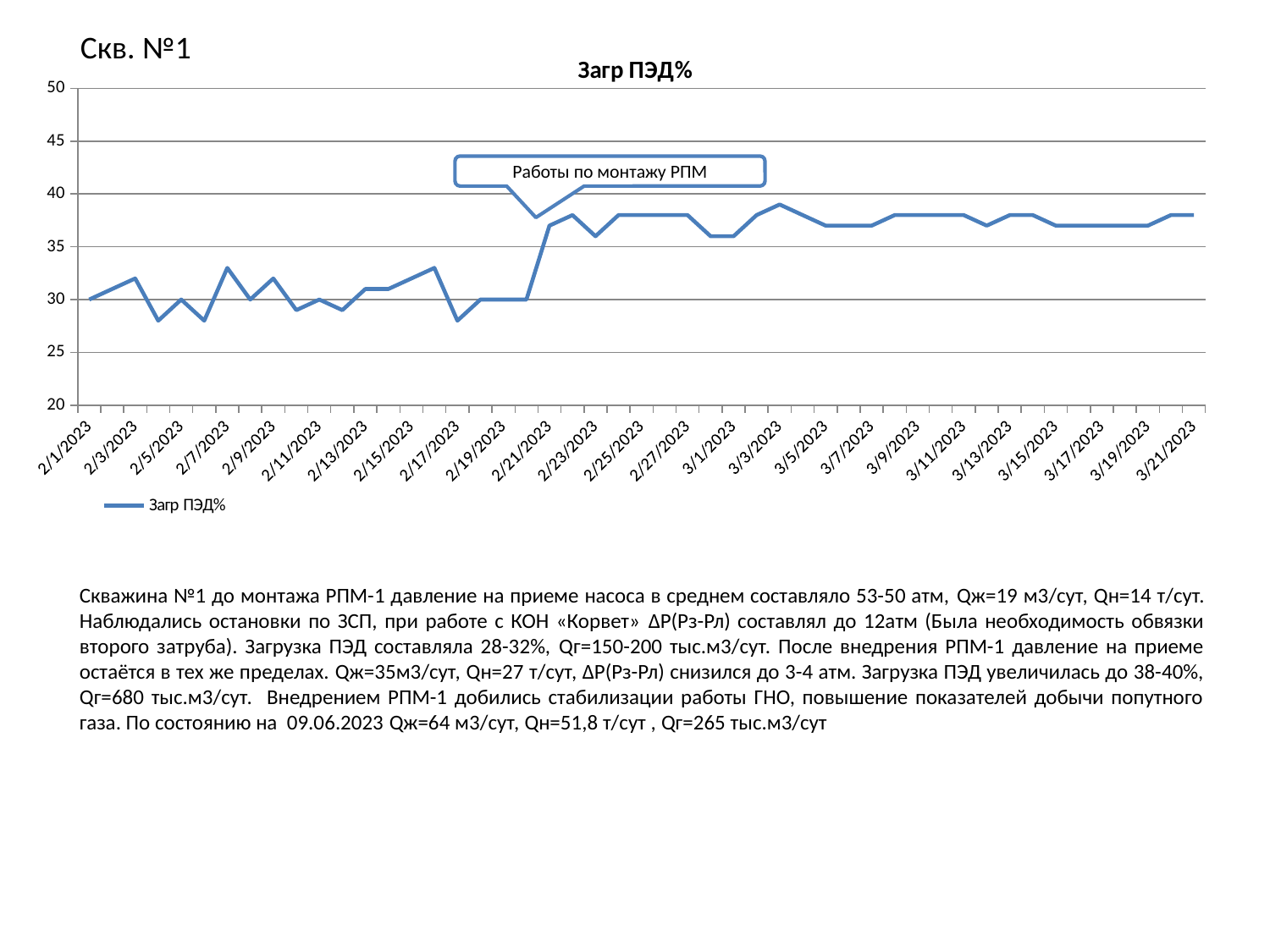
What is the title of the chart? Загр ПЭД% Is the value for 2/17/2023 greater or less than 30? less What kind of chart is shown on the slide? line chart What is the value of Загр ПЭД% on 2/19/2023? 30 Which date has the highest value of Загр ПЭД%? 3/3/2023 Is the value for 3/21/2023 greater or less than 35? greater What is the value of Загр ПЭД% on 2/1/2023? 30 Which is larger, the value on 2/21/2023 or the value on 2/1/2023? 2/21/2023 Do the values generally rise or fall from 2/1/2023 to 3/21/2023? rise Is the value for 3/3/2023 greater or less than 35? greater How many series does the legend list? 1